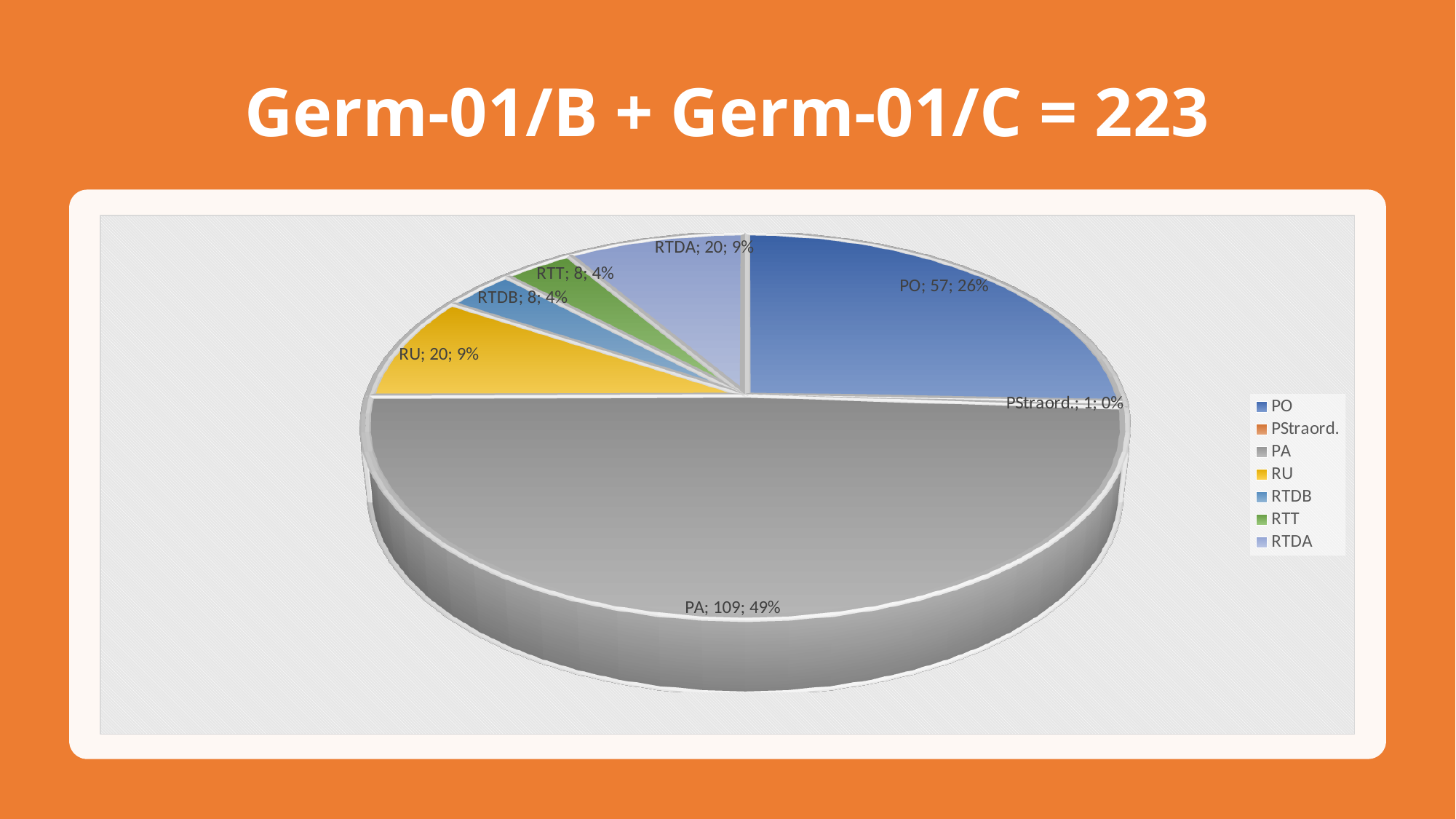
What is the value for PStraord.? 1 Which category has the smallest slice? PStraord. What share of the pie does PA represent? 49% Which category has the largest slice? PA What is the value for PA? 109 What share of the pie does PO represent? 26% What is the value for PO? 57 How many categories does the legend list? 7 What is the value for RTDA? 20 What kind of chart is shown on the slide? pie chart Which is larger, the value for RU or the value for RTT? RU What is the difference between the values for PA and PO? 52